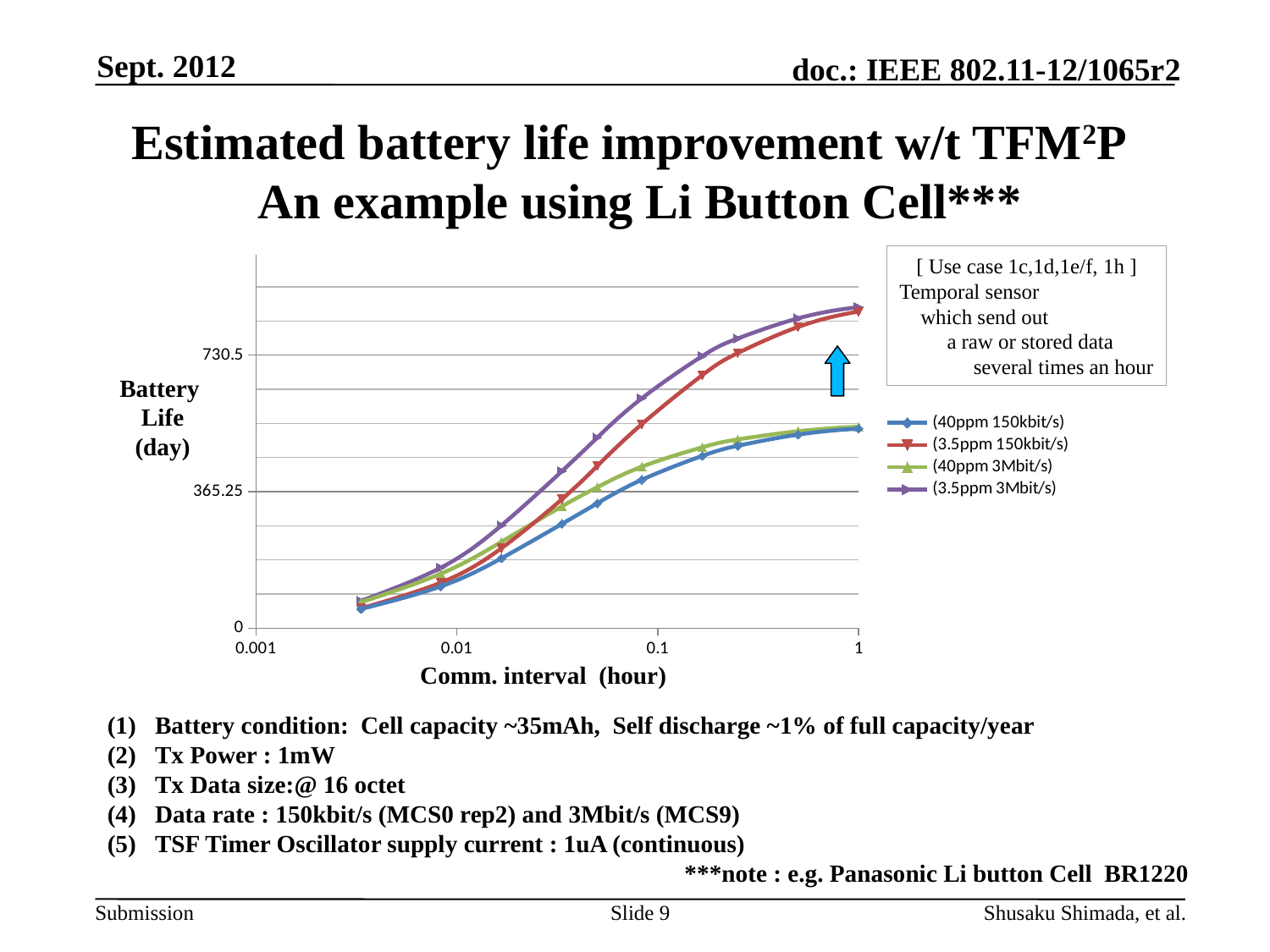
At a communication interval of 0.1 hour, is the battery life for (3.5ppm 150kbit/s) greater or less than 365.25 days? greater At a communication interval of 1 hour, which series has the higher battery life: (3.5ppm 3Mbit/s) or (40ppm 150kbit/s)? (3.5ppm 3Mbit/s) At a communication interval of 1 hour, is the battery life for (3.5ppm 3Mbit/s) greater or less than 730.5 days? greater Which series reaches the highest battery life on the chart? (3.5ppm 3Mbit/s) What is the label of the x axis of the chart? Comm. interval (hour) What is the label of the y axis of the chart? Battery Life (day) At a communication interval of 1 hour, is the battery life for (40ppm 150kbit/s) greater or less than 365.25 days? greater What kind of chart is shown on the slide? line chart How many series does the chart legend list? 4 Does battery life rise or fall as the communication interval increases along the x axis? rise